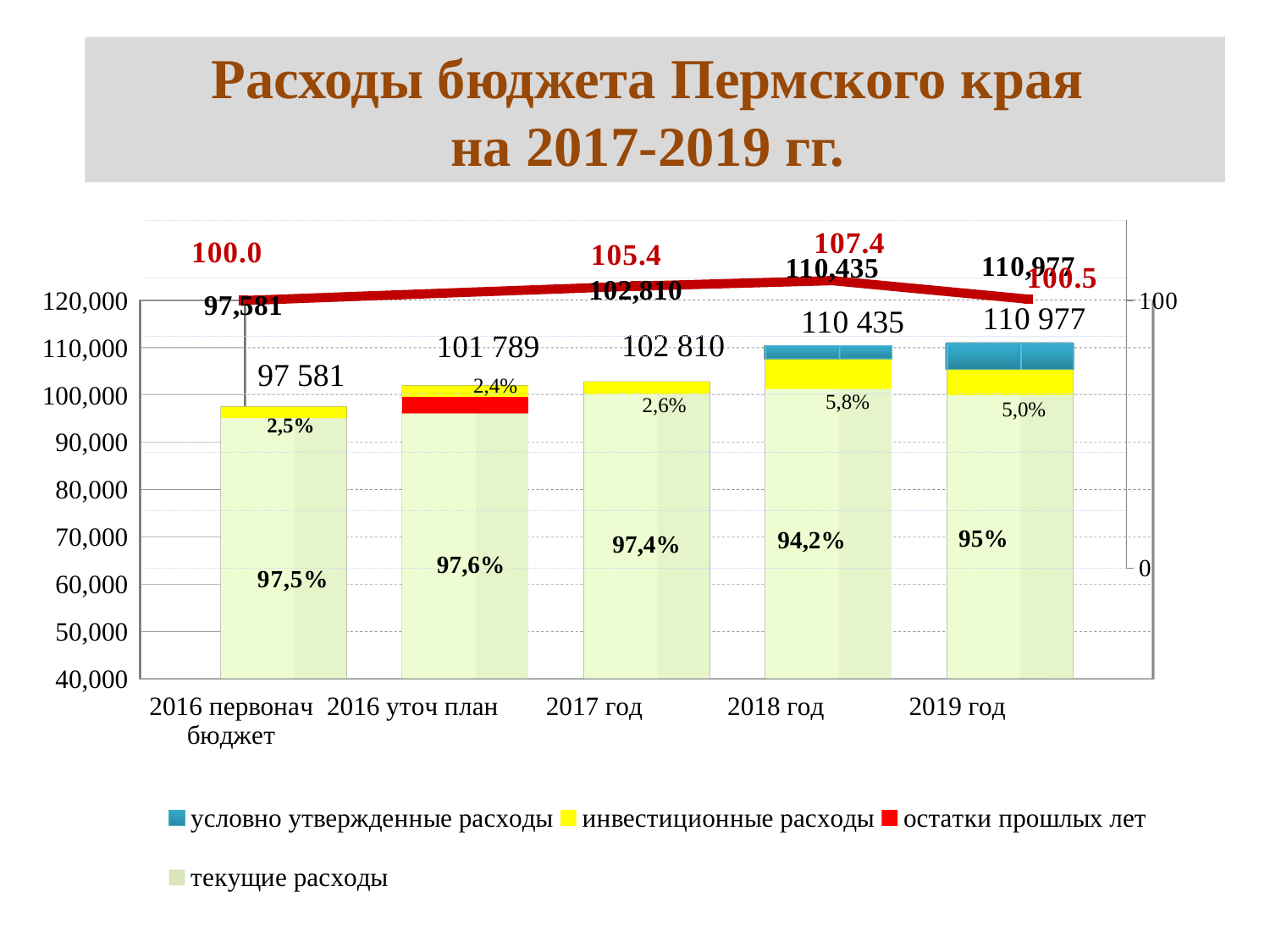
What is the total expenditure value shown for 2019 год? 110 977 What share of the bar is labelled for текущие расходы in 2018 год? 94,2% Which category has the highest total expenditure? 2019 год Which category has the lowest total expenditure? 2016 первонач бюджет How many categories are shown on the x axis? 5 What percentage is labelled for инвестиционные расходы in 2016 первонач бюджет? 2,5% Which is larger, the total for 2016 уточ план or the total for 2017 год? 2017 год What kind of chart is shown on the slide? Stacked bar chart with a line How many series does the legend list? 4 What is the total expenditure value shown for 2017 год? 102 810 What is the red line value labelled above 2018 год? 107.4 What is the difference between the total for 2018 год and the total for 2017 год? 7 625